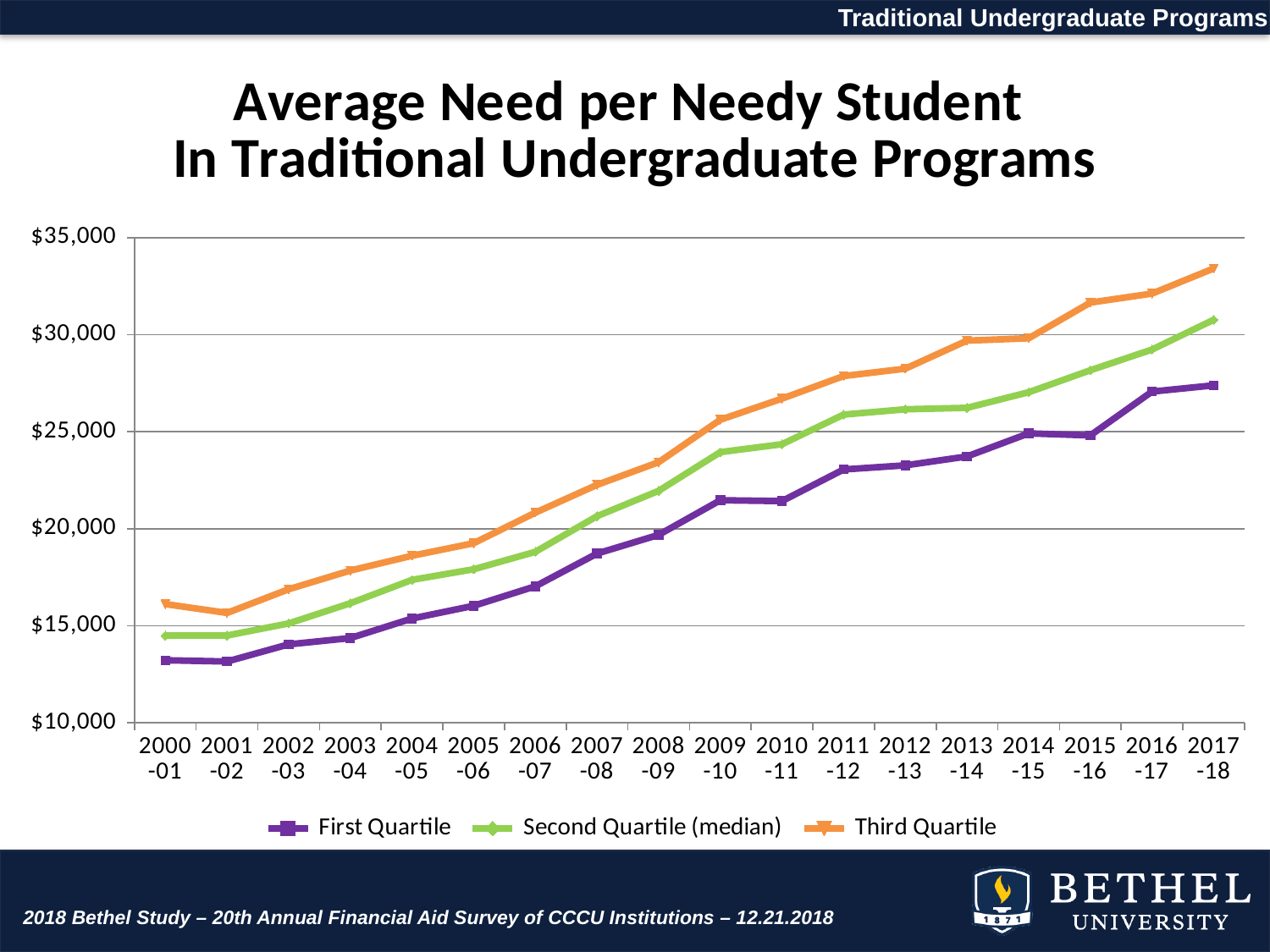
Is the Third Quartile value for 2000-01 greater or less than $15,000? greater How many academic years are plotted along the x axis? 18 Is the First Quartile value for 2017-18 greater or less than $25,000? greater Do the Third Quartile values generally rise or fall from 2000-01 to 2017-18? Rise How many series does the legend list? 3 Which series is shown in orange in the legend? Third Quartile In which academic year does the Third Quartile reach its highest value? 2017-18 What kind of chart is shown on the slide? Line chart Is the Second Quartile (median) value for 2009-10 greater or less than $25,000? less In 2010-11, which is larger: the Third Quartile value or the First Quartile value? Third Quartile